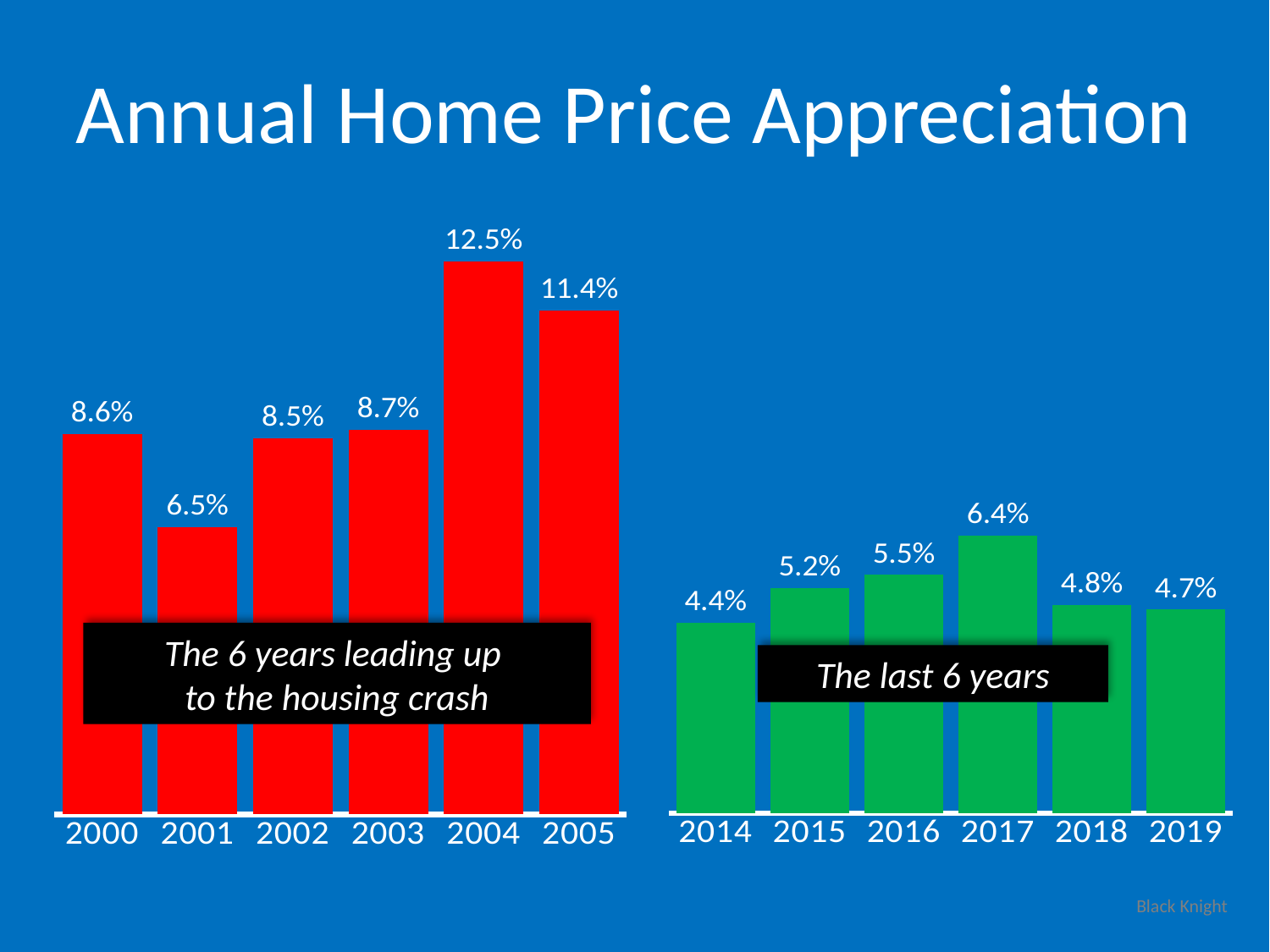
In the right chart (the last 6 years), which year has the highest value? 2017 In the right chart (the last 6 years), what is the difference between the values for 2017 and 2014? 2.0% In the left chart (the 6 years leading up to the housing crash), which year has the lowest value? 2001 In the right chart (the last 6 years), which year has the lowest value? 2014 In the left chart (the 6 years leading up to the housing crash), what is the value for 2004? 12.5% In the right chart (the last 6 years), do the values rise or fall from 2014 to 2017? Rise In the left chart (the 6 years leading up to the housing crash), which is larger, the value for 2000 or the value for 2001? 2000 How many years are shown in the right chart (the last 6 years)? 6 What kind of chart is the left chart (the 6 years leading up to the housing crash)? Bar chart In the left chart (the 6 years leading up to the housing crash), what is the difference between the values for 2004 and 2005? 1.1% In the right chart (the last 6 years), what is the value for 2017? 6.4% What colour are the bars in the right chart (the last 6 years)? Green